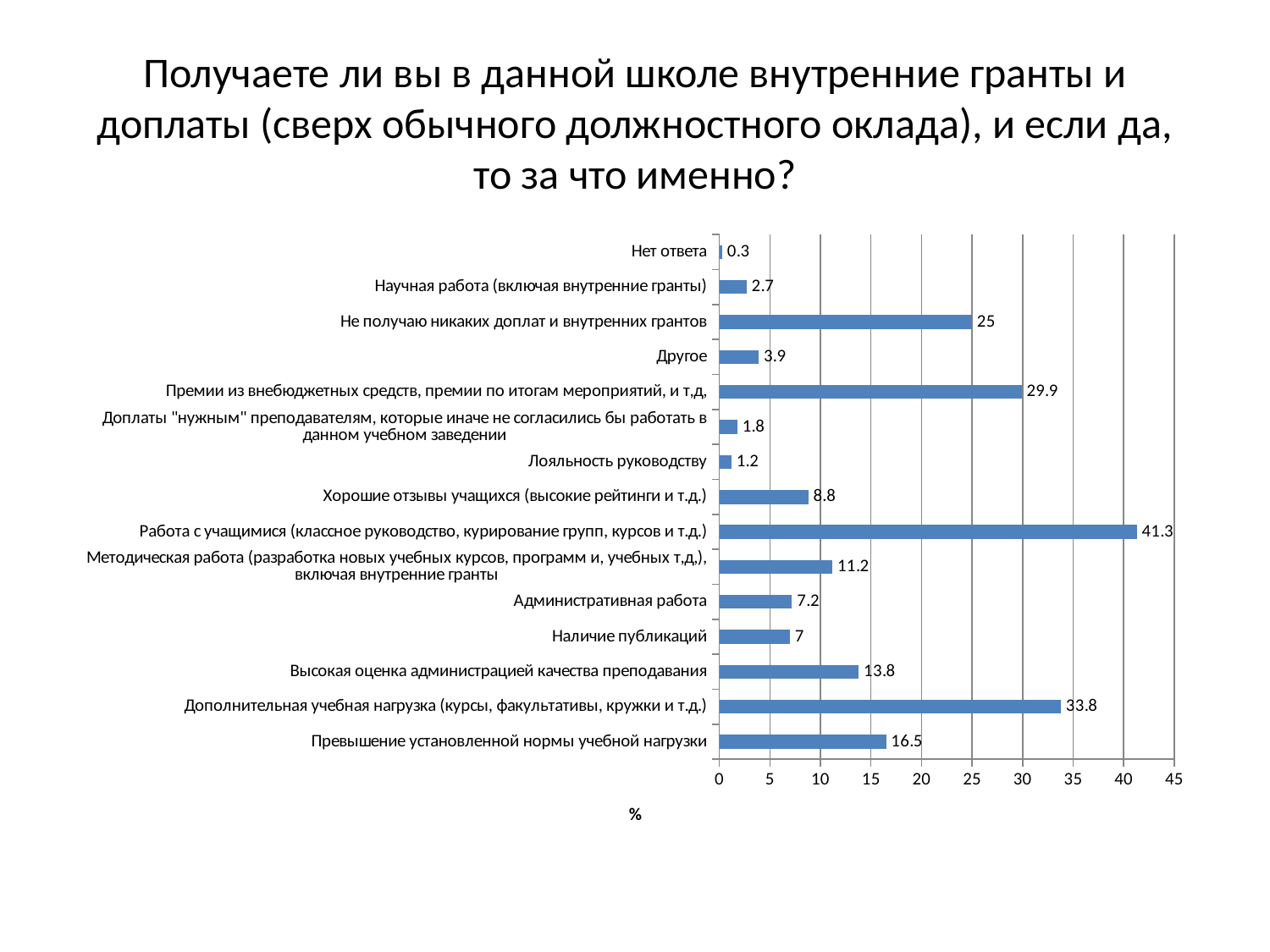
What kind of chart is shown on the slide? bar chart What unit label is shown below the horizontal axis? % What is the value for "Работа с учащимися (классное руководство, курирование групп, курсов и т.д.)"? 41.3 Which category has the lowest value? Нет ответа Is the value for "Высокая оценка администрацией качества преподавания" greater or less than 15? less What is the value for "Не получаю никаких доплат и внутренних грантов"? 25 What is the difference between the values for "Премии из внебюджетных средств, премии по итогам мероприятий, и т.д." and "Превышение установленной нормы учебной нагрузки"? 13.4 Which category has the highest value? Работа с учащимися (классное руководство, курирование групп, курсов и т.д.) Which is larger: the value for "Административная работа" or the value for "Хорошие отзывы учащихся (высокие рейтинги и т.д.)"? Хорошие отзывы учащихся (высокие рейтинги и т.д.) What is the value for "Лояльность руководству"? 1.2 What is the value for "Дополнительная учебная нагрузка (курсы, факультативы, кружки и т.д.)"? 33.8 How many categories are shown in the chart? 15